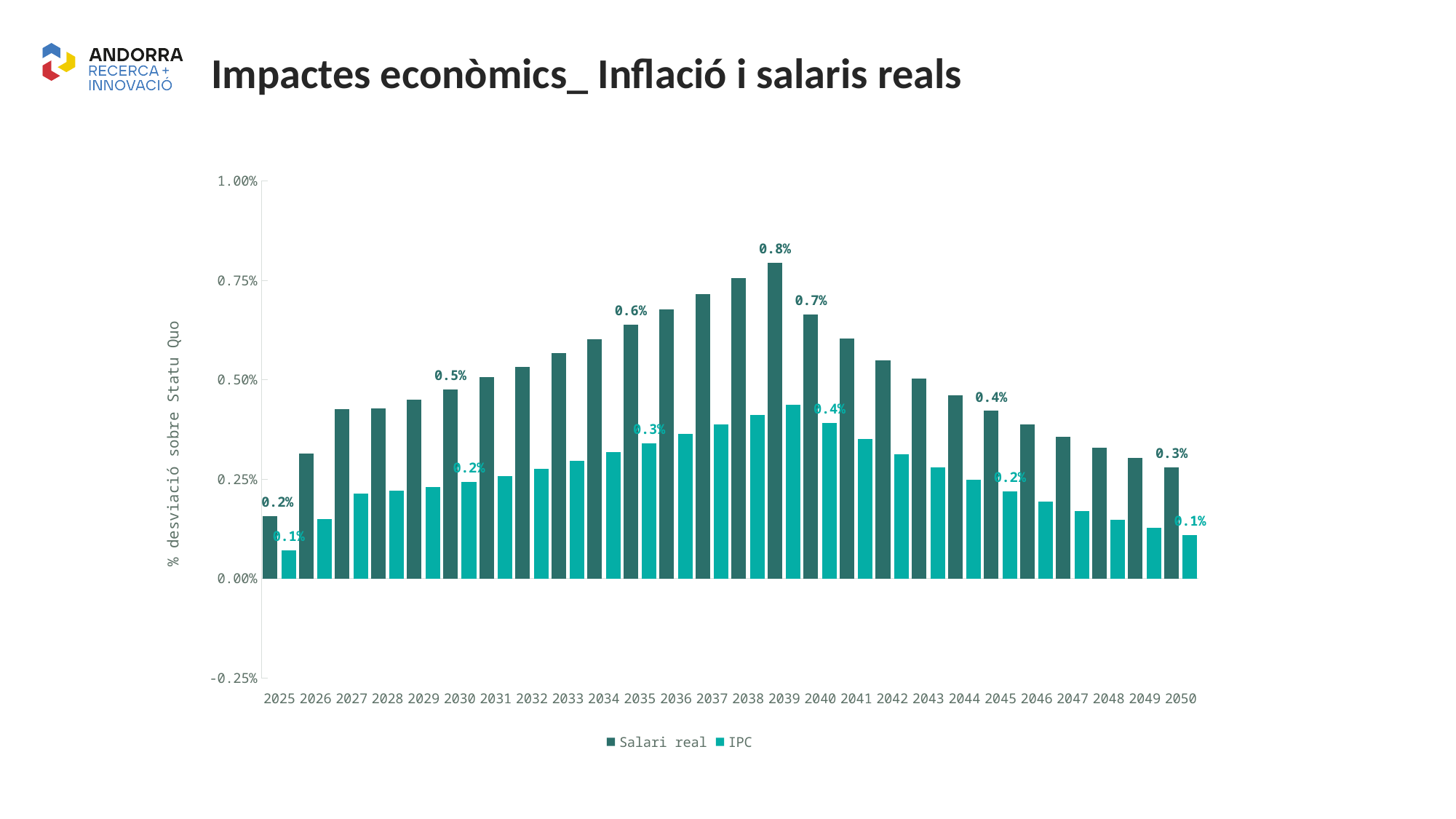
What is the difference between the Salari real and IPC values in 2045? 0.2% Which is larger in 2050, the Salari real value or the IPC value? Salari real Is the Salari real value for 2037 greater or less than 0.50%? greater Does the IPC series rise or fall from 2040 to 2050? fall What kind of chart is shown on the slide? bar chart What is the Salari real value for 2040? 0.7% How many series does the legend list? 2 Which year has the highest Salari real value? 2039 What are the two series named in the legend? Salari real and IPC What is the Salari real value for 2030? 0.5% How many years are shown on the x axis? 26 What is the IPC value for 2035? 0.3%